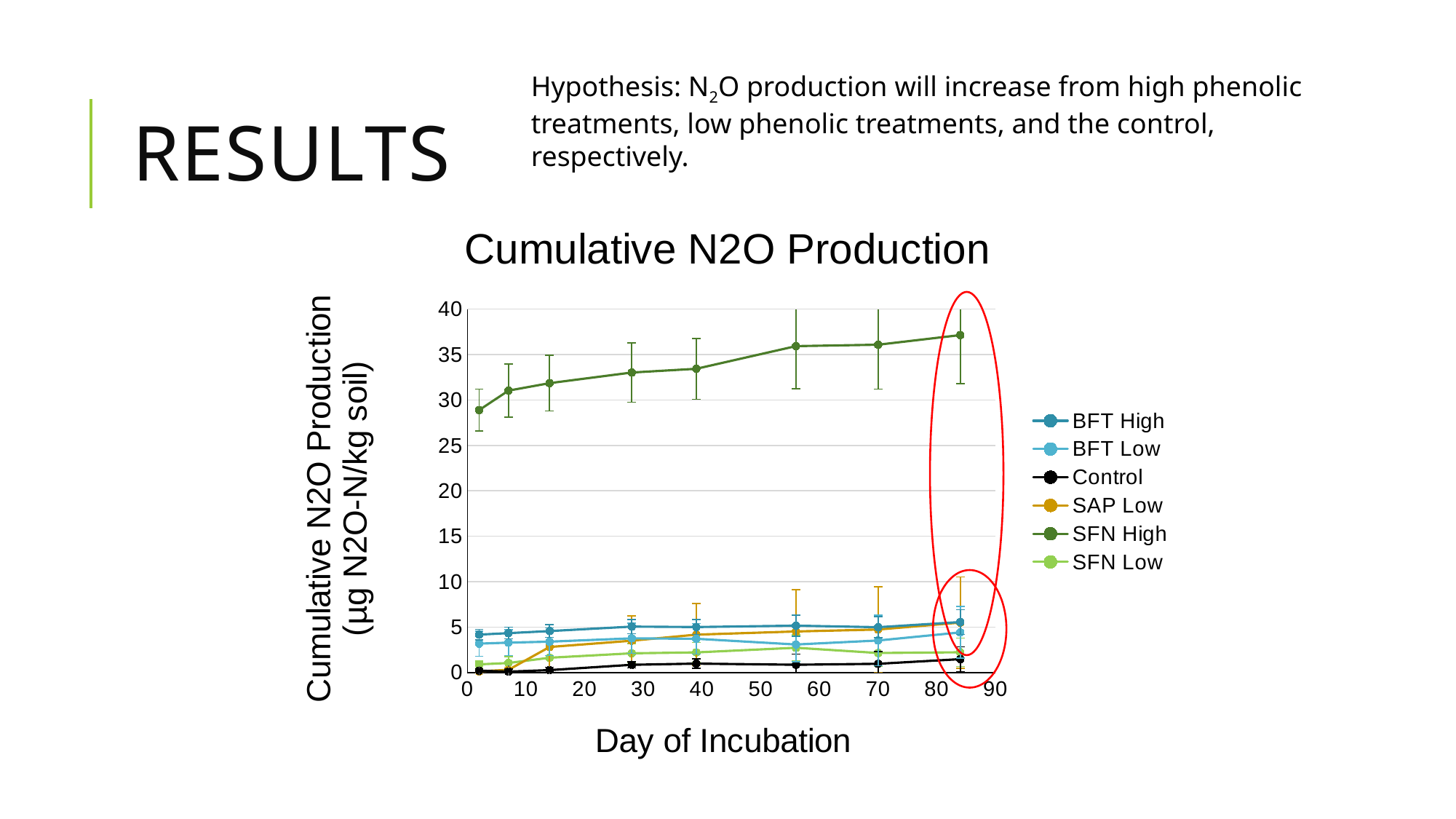
Does the SFN High series rise or fall as the day of incubation increases? rise Which series has the highest cumulative N2O production throughout the incubation? SFN High Which series has the larger value at day 70, SFN High or BFT High? SFN High Is the value for SFN High at the first measurement greater or less than 25? greater How many measurement points are plotted for the SFN High series? 8 What is the title of the chart? Cumulative N2O Production What kind of chart is shown on the slide? line chart How many series does the legend list? 6 Is the value for SFN High at the final measurement (around day 84) greater or less than 35? greater What is the label of the x axis? Day of Incubation Is the value for Control at the final measurement greater or less than 5? less